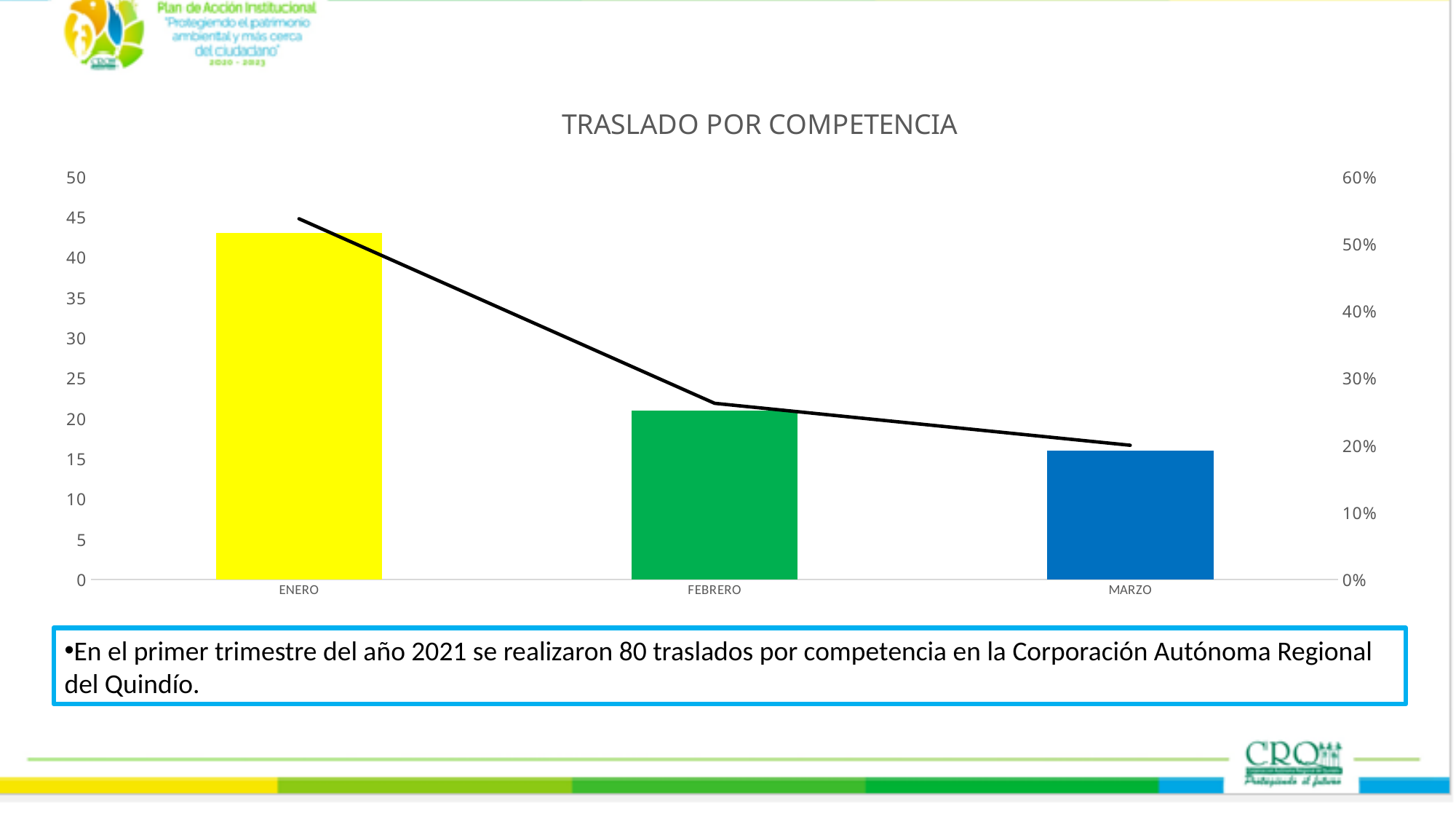
How many categories are shown on the x axis of the chart? 3 What is the title of the chart? TRASLADO POR COMPETENCIA What type of chart is shown on the slide? bar chart with a line Which bar is taller, FEBRERO or MARZO? FEBRERO Is the bar value for MARZO greater or less than 20? less Do the bar values rise or fall from ENERO to MARZO? fall Is the bar value for ENERO greater or less than 40? greater Which bar is taller, ENERO or FEBRERO? ENERO Which month has the highest bar in the chart? ENERO Which month has the lowest bar in the chart? MARZO Is the bar value for FEBRERO greater or less than 25? less